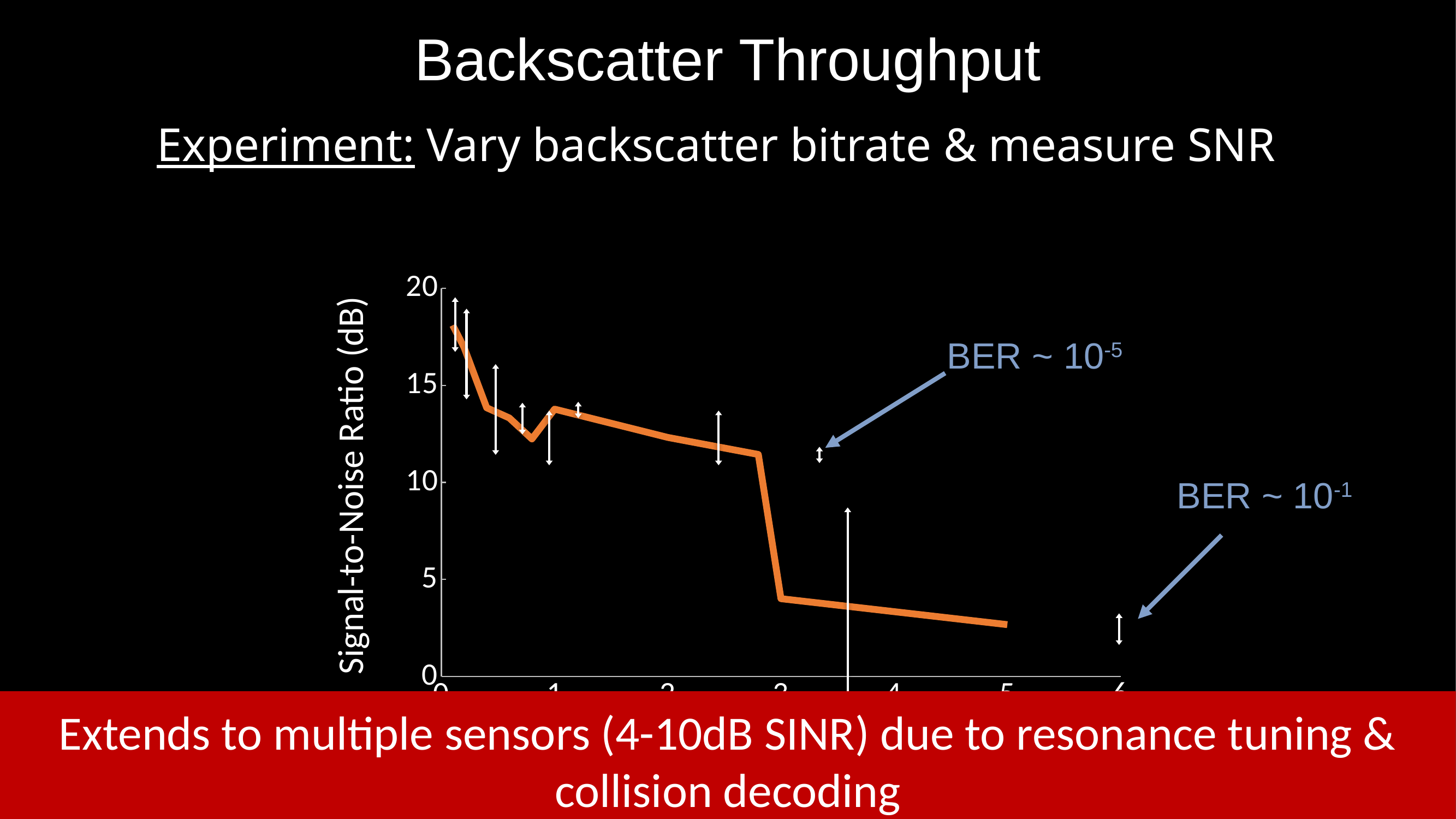
At which x-axis value is the Signal-to-Noise Ratio highest? 0 Is the Signal-to-Noise Ratio at x = 2 greater or less than 10? greater Between which two x-axis values does the Signal-to-Noise Ratio drop sharply from above 10 to below 5? 2 and 3 What is the highest tick value shown on the y axis? 20 Is the Signal-to-Noise Ratio at x = 0 greater or less than 15? greater What kind of chart is shown on the slide? line chart Is the Signal-to-Noise Ratio at x = 4 greater or less than 5? less What is the label of the y axis? Signal-to-Noise Ratio (dB) Which is larger, the Signal-to-Noise Ratio at x = 1 or at x = 4? x = 1 Does the Signal-to-Noise Ratio rise or fall as the x-axis value increases from 0 to 5? fall How many lines (series) are plotted on the chart? 1